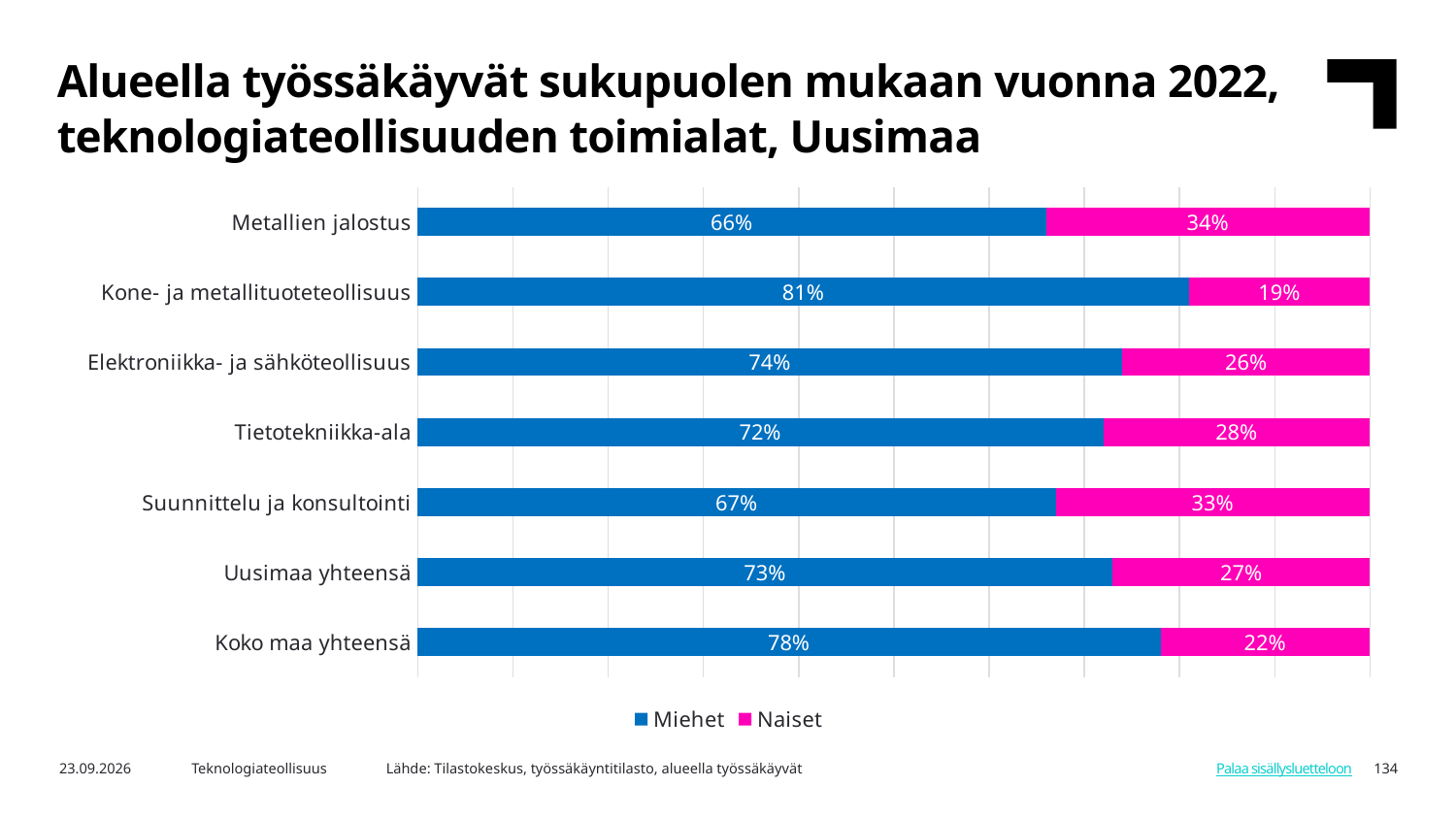
What is the Naiset share for Koko maa yhteensä? 22% What kind of chart is shown on the slide? Stacked bar chart How many categories are shown on the chart? 7 Which category has the highest Miehet share? Kone- ja metallituoteteollisuus What is the Miehet share for Uusimaa yhteensä? 73% What is the Naiset share for Metallien jalostus? 34% What is the Miehet share for Kone- ja metallituoteteollisuus? 81% Which category has the highest Naiset share? Metallien jalostus Which category has the lowest Miehet share? Metallien jalostus What is the difference between the Miehet share for Koko maa yhteensä and Uusimaa yhteensä? 5 percentage points How many series does the legend list? 2 Is the Naiset share larger for Tietotekniikka-ala or for Elektroniikka- ja sähköteollisuus? Tietotekniikka-ala